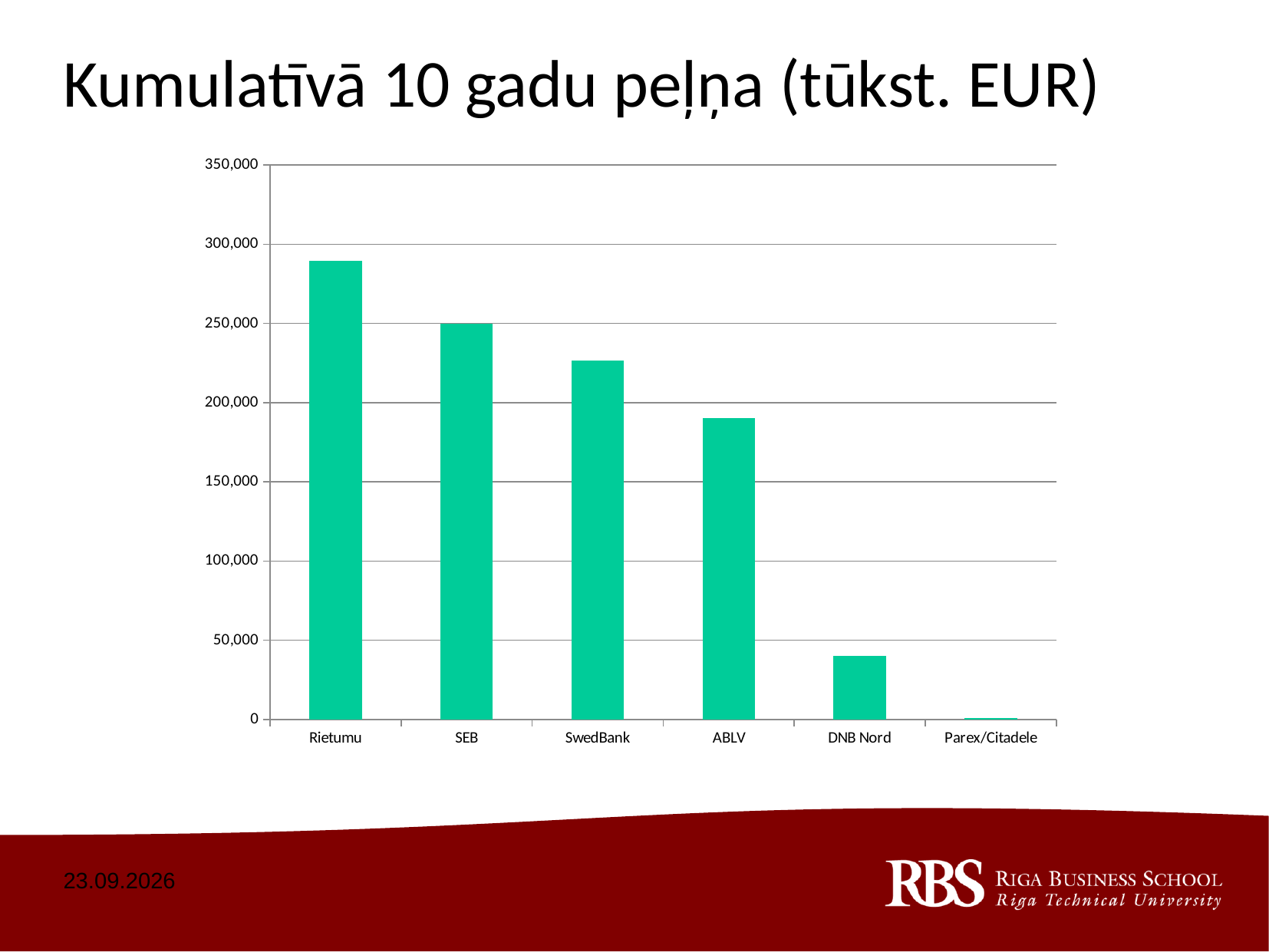
Is the value for DNB Nord greater or less than 50,000? less Do the bar values rise or fall moving from left to right along the x axis? fall What is the title of the slide containing the chart? Kumulatīvā 10 gadu peļņa (tūkst. EUR) What kind of chart is shown on the slide? bar chart Which bank has the lowest cumulative 10-year profit in the chart? Parex/Citadele Which bank has a larger cumulative profit, SEB or ABLV? SEB Which bank has a larger cumulative profit, DNB Nord or SwedBank? SwedBank How many banks are shown on the x axis of the chart? 6 Is the value for Rietumu greater or less than 250,000? greater Which bank has the highest cumulative 10-year profit in the chart? Rietumu Is the value for ABLV greater or less than 200,000? less